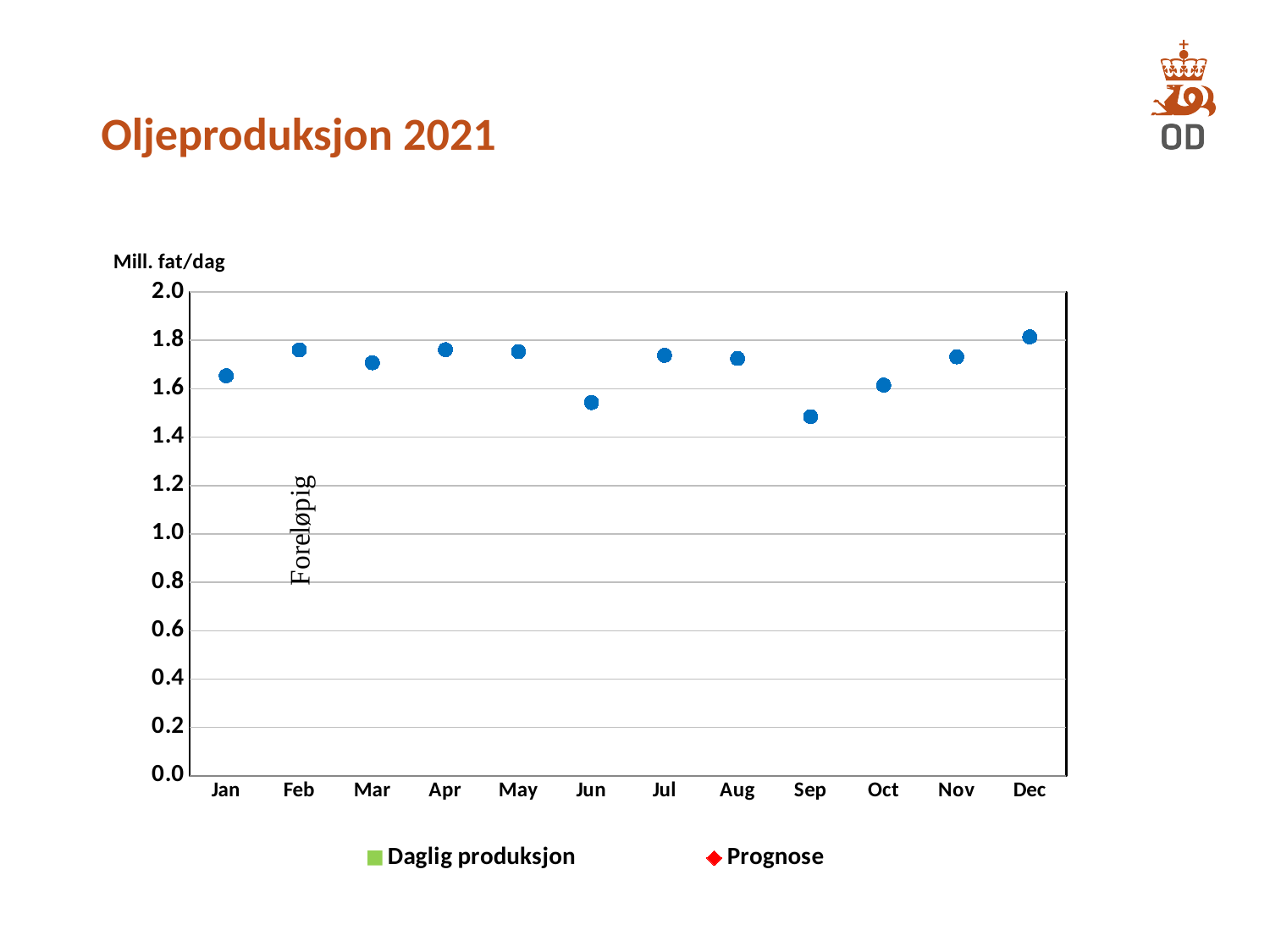
Is the value for Jun greater or less than 1.6? less Do the values rise or fall from Sep to Dec? rise Which is larger, the value for Oct or the value for Sep? Oct Which is larger, the value for Jun or the value for Sep? Jun How many months (data points) are plotted on the chart? 12 Is the value for Dec greater or less than 1.6? greater How many series does the legend list? 2 Is the value for Sep greater or less than 1.6? less Which month has the highest plotted value? Dec What kind of chart is shown on the slide? scatter chart What is the title of the chart on the slide? Oljeproduksjon 2021 Which month has the lowest plotted value? Sep